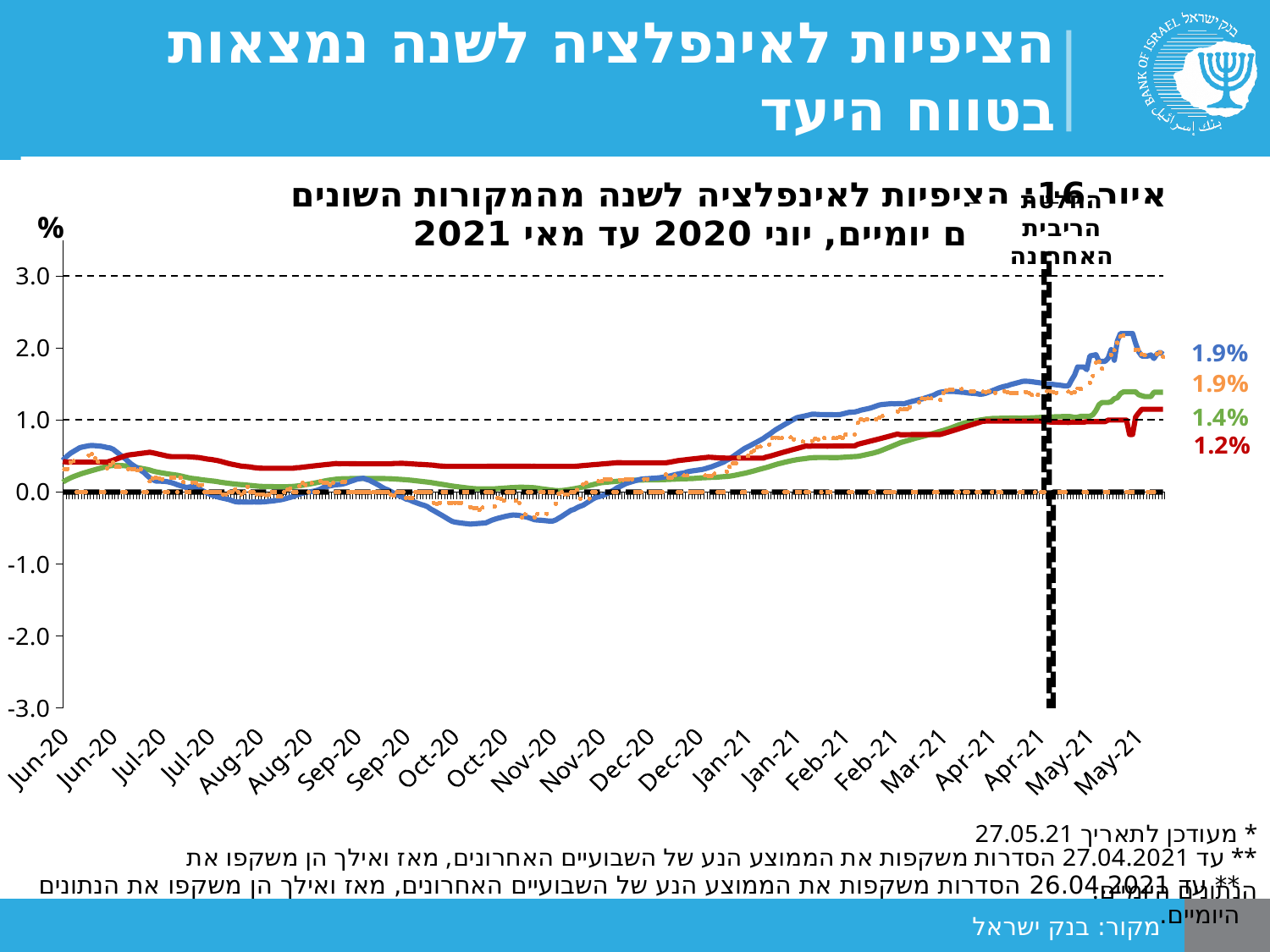
What unit is shown on the vertical axis of the chart? % What is the end value labelled for the red line? 1.2% What is the end value labelled for the green line? 1.4% What is the end value labelled for the orange dashed line? 1.9% What is the end value labelled for the blue line? 1.9% What is the difference between the labelled end values of the green line and the red line? 0.2 percentage points Which line has the lowest labelled end value? the red line (1.2%) Does the blue line rise or fall between Jan-21 and May-21? rise Which has a higher labelled end value, the green line or the red line? the green line What kind of chart is shown on the slide? line chart Is the value of the blue line in Oct-20 greater or less than 0.0? less